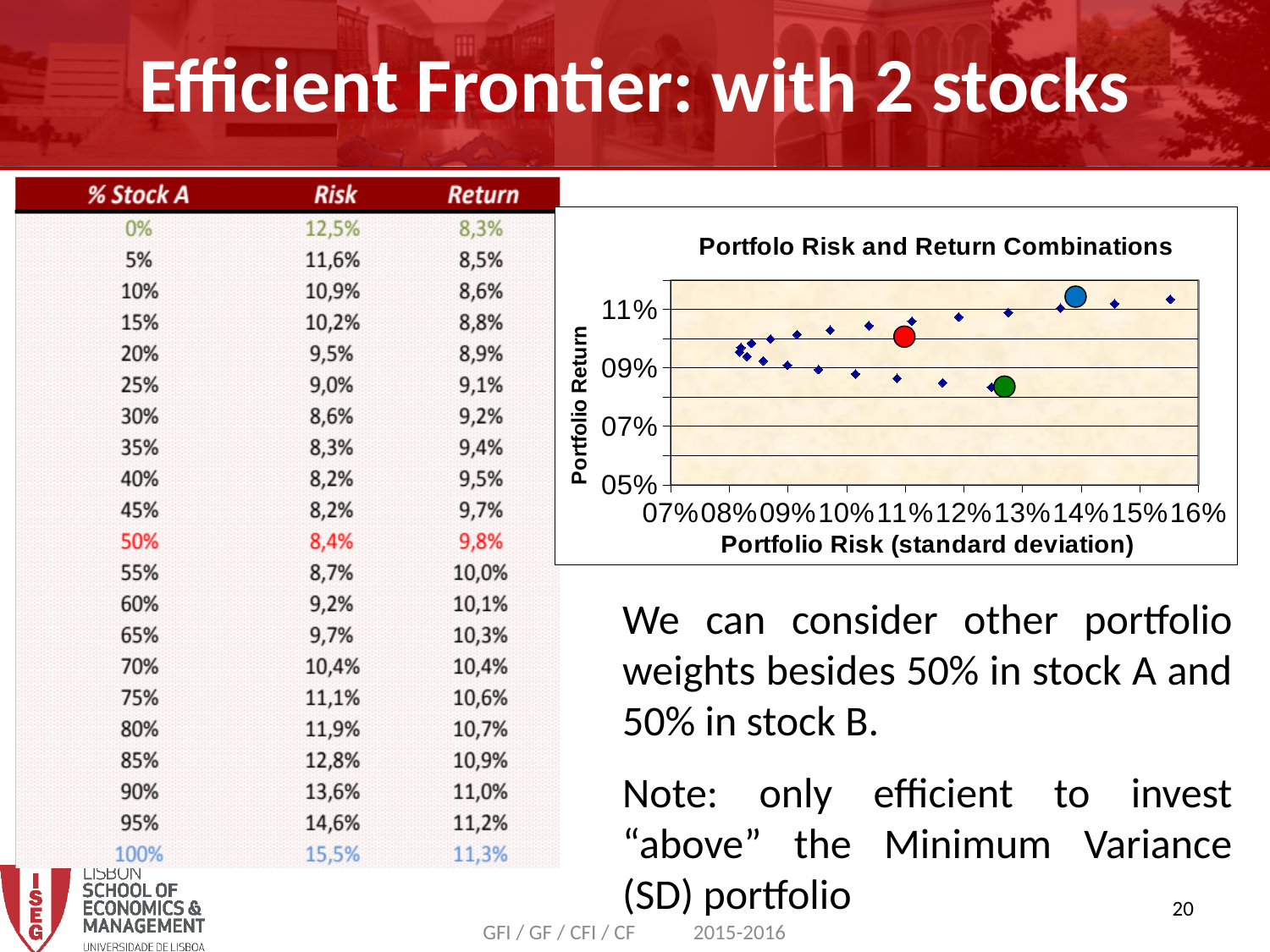
What kind of chart is shown on the slide? scatter chart Is the portfolio return of the green highlighted point greater or less than 09%? less Is the portfolio risk of the red highlighted point greater or less than 10%? greater How many portfolio weight combinations (% Stock A) are listed in the table on the slide? 21 Is the portfolio return of the red highlighted point greater or less than 09%? greater What is the highest tick value shown on the y axis of the chart? 11% Which highlighted point has the lowest portfolio return? the green one Along the upper branch of points, does portfolio return rise or fall as portfolio risk increases? rises What is the label of the x axis of the chart? Portfolio Risk (standard deviation) What is the title of the chart? Portfolo Risk and Return Combinations Which highlighted point has the higher portfolio return, the blue one or the green one? the blue one